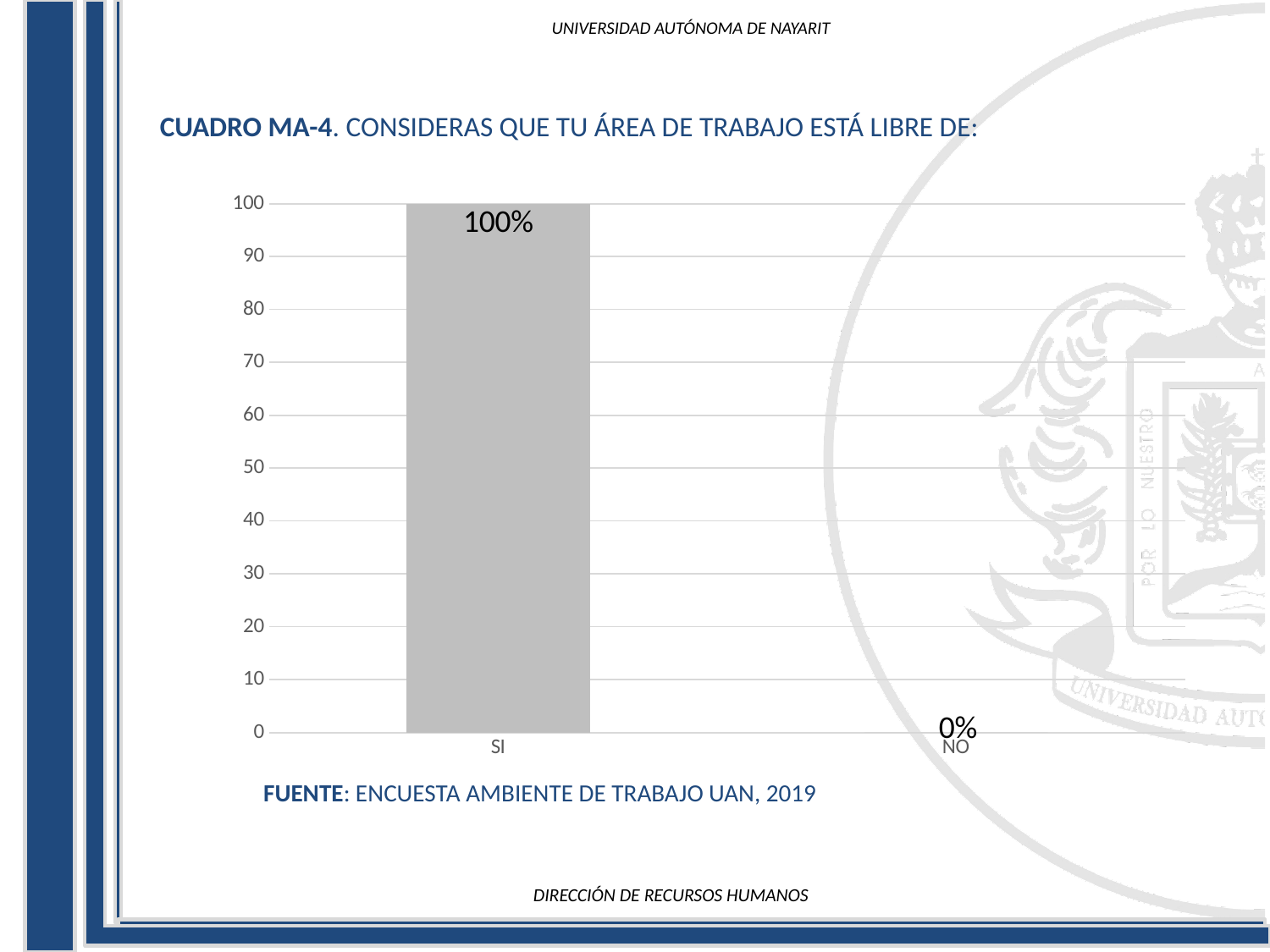
What is the value for SI? 100% What is the value for NO? 0% Which category has the lowest value? NO Which category has the highest value? SI What is the difference between the values for SI and NO? 100% How many categories are shown on the x axis? 2 Do the values rise or fall from SI to NO? fall What kind of chart is shown on the slide? bar chart What is the maximum value shown on the vertical axis? 100 What is the source cited below the chart? ENCUESTA AMBIENTE DE TRABAJO UAN, 2019 Which is larger, the value for SI or the value for NO? SI Is the value for SI greater or less than 50? greater